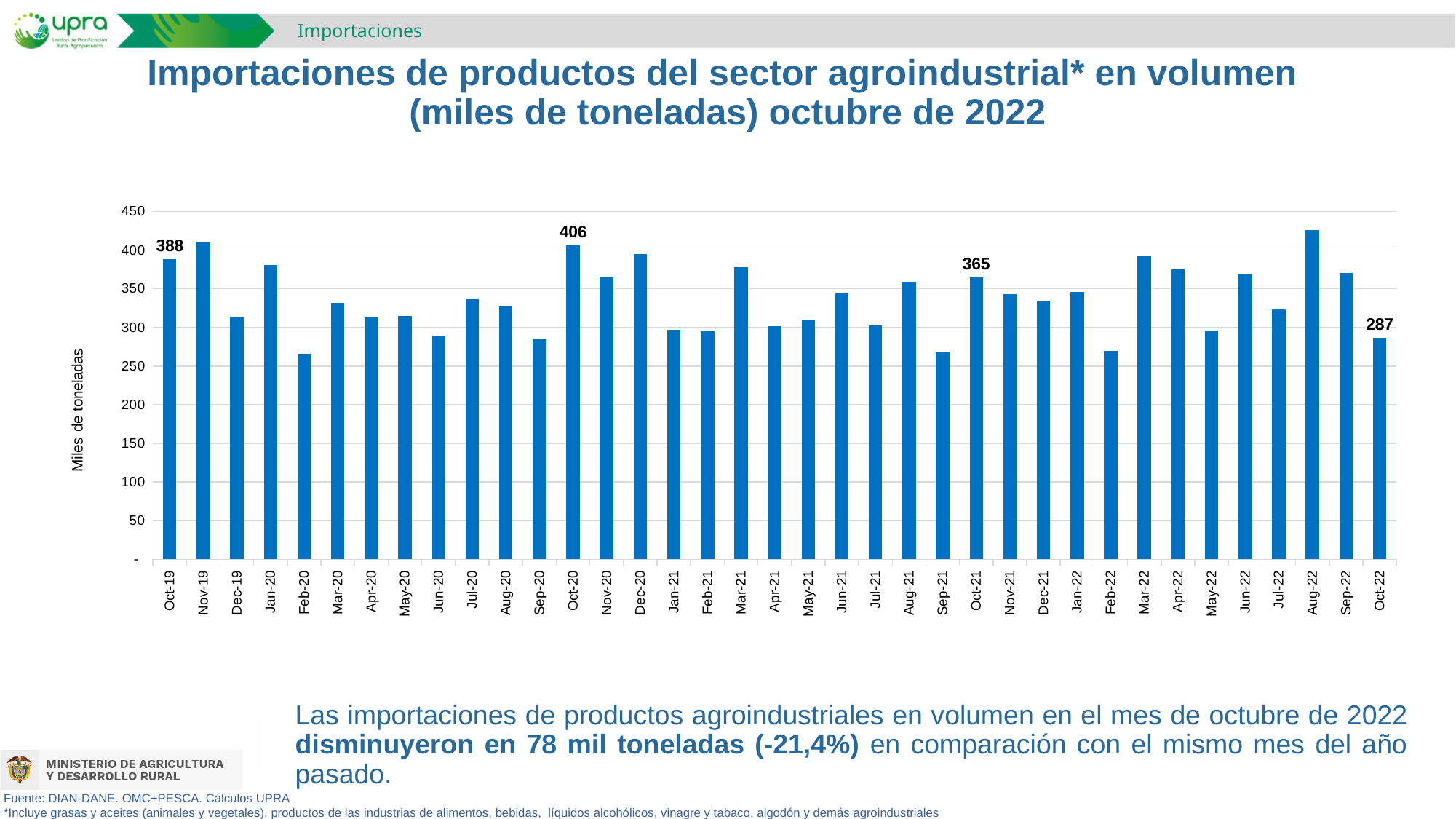
What is the value for Oct-20? 406 Which month has the highest bar in the chart? Aug-22 What is the value for Oct-22? 287 What is the difference between the values for Oct-21 and Oct-22? 78 What is the value for Oct-21? 365 How many months are plotted in the chart? 37 What kind of chart is shown on the slide? bar chart Is the value for Feb-20 greater or less than 300? less What is the label of the vertical axis? Miles de toneladas Which is larger, the value for Oct-19 or the value for Oct-20? Oct-20 What is the value for Oct-19? 388 Is the value for Aug-22 greater or less than 400? greater